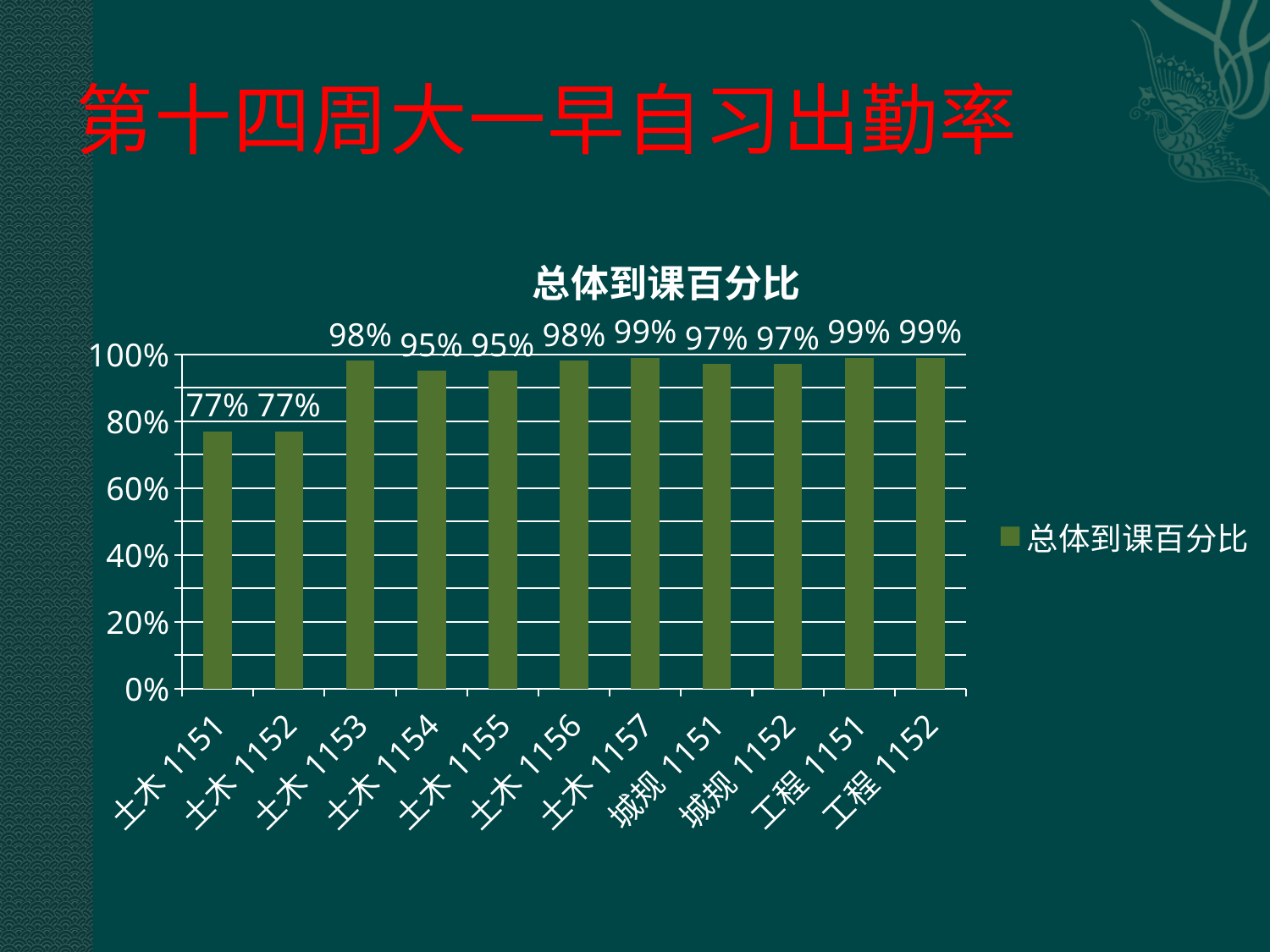
What kind of chart is shown on the slide? bar chart What is the value for 城规1152? 97% What is the value for 土木1151? 77% Is the value for 土木1152 greater or less than 80%? less What is the highest value shown in the chart? 99% How many categories are shown on the x axis? 11 What is the lowest value shown in the chart? 77% What is the value for 工程1151? 99% What is the value for 土木1154? 95% How many series does the legend list? 1 Which has a larger value, 土木1157 or 土木1154? 土木1157 What is the difference between the values for 土木1153 and 土木1151? 21 percentage points